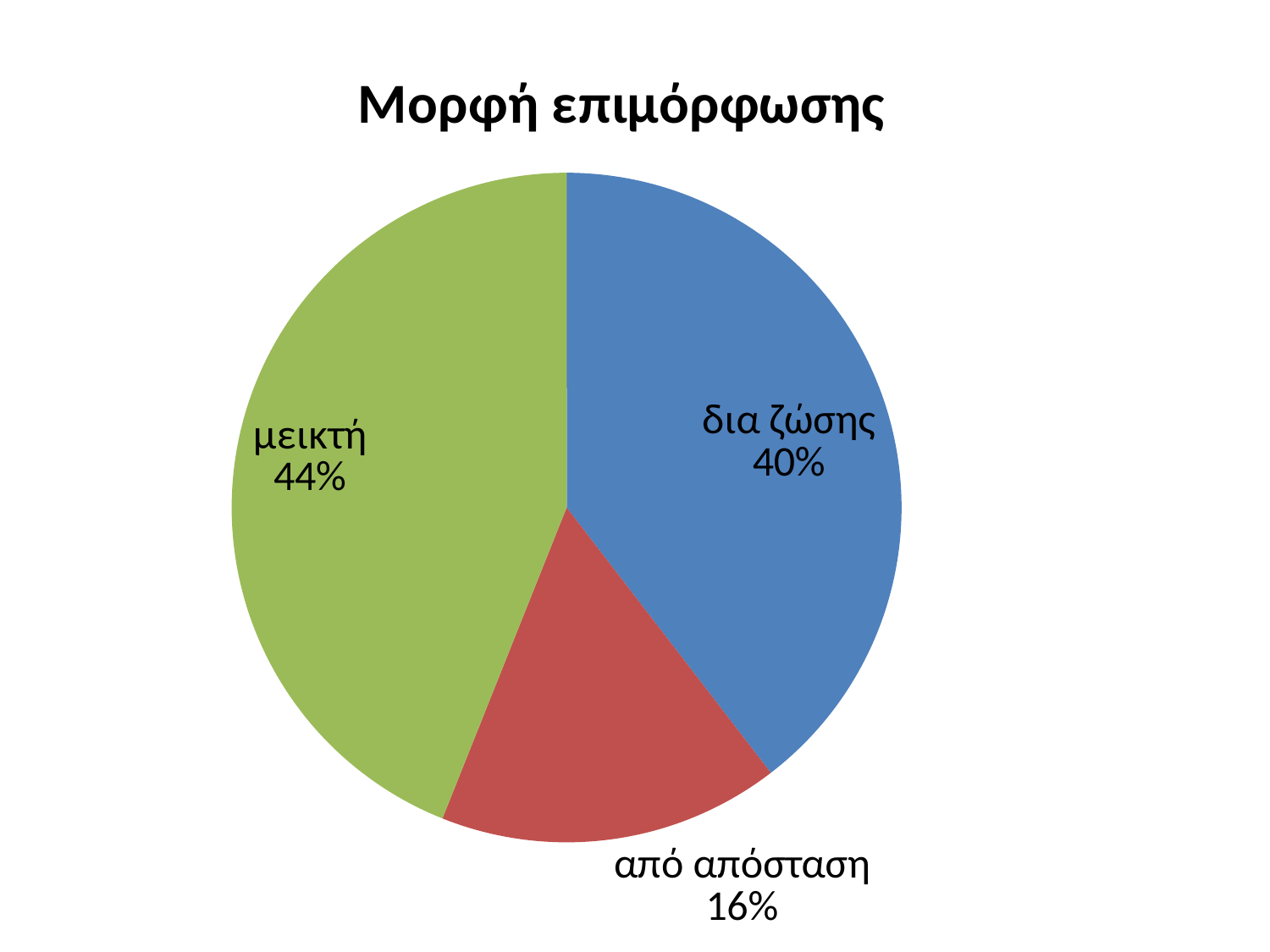
What is the difference in percentage points between μεικτή and δια ζώσης? 4% What kind of chart is shown on the slide? pie chart Which category has the largest slice? μεικτή What share of the pie does από απόσταση have? 16% What is the title of the chart? Μορφή επιμόρφωσης How many slices does the pie chart have? 3 Which category has the smallest slice? από απόσταση Which is larger, the slice for δια ζώσης or the slice for από απόσταση? δια ζώσης What is the difference in percentage points between δια ζώσης and από απόσταση? 24% What share of the pie does δια ζώσης have? 40% What share of the pie does μεικτή have? 44% What colour is the slice for από απόσταση? red